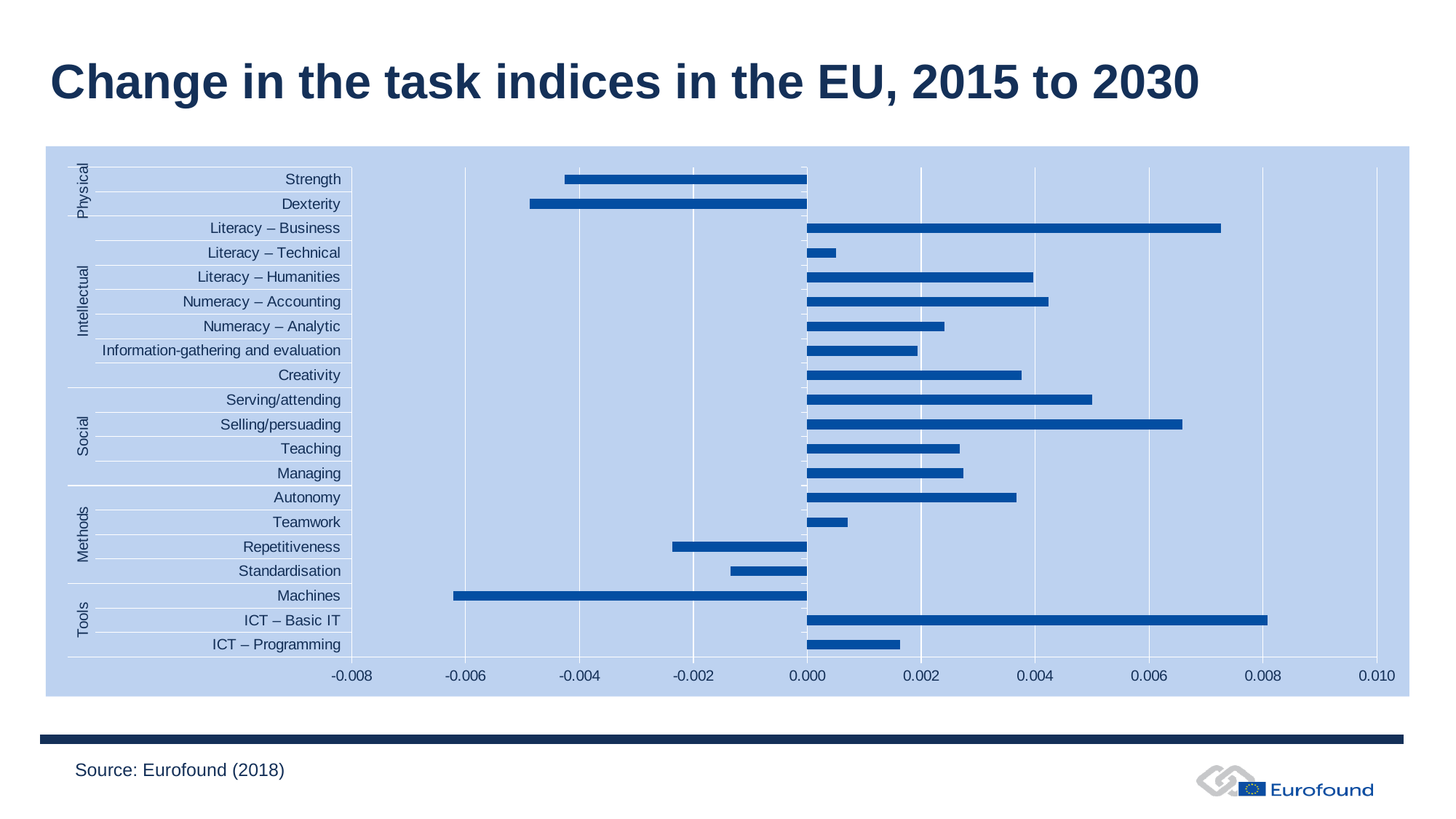
What is the title of the chart? Change in the task indices in the EU, 2015 to 2030 Is the value for Teamwork greater or less than 0.002? less How many task indices are plotted in the chart? 20 Which task index shows the largest decrease from 2015 to 2030? Machines Which has the larger value, Creativity or Information-gathering and evaluation? Creativity Is the value for Dexterity greater or less than -0.004? less What kind of chart is shown on the slide? bar chart Is the value for Literacy – Business greater or less than 0.006? greater Which task index shows the largest increase from 2015 to 2030? ICT – Basic IT How many task groups (such as Physical and Social) are labelled along the left side of the chart? 5 Which has the larger value, Selling/persuading or Teaching? Selling/persuading